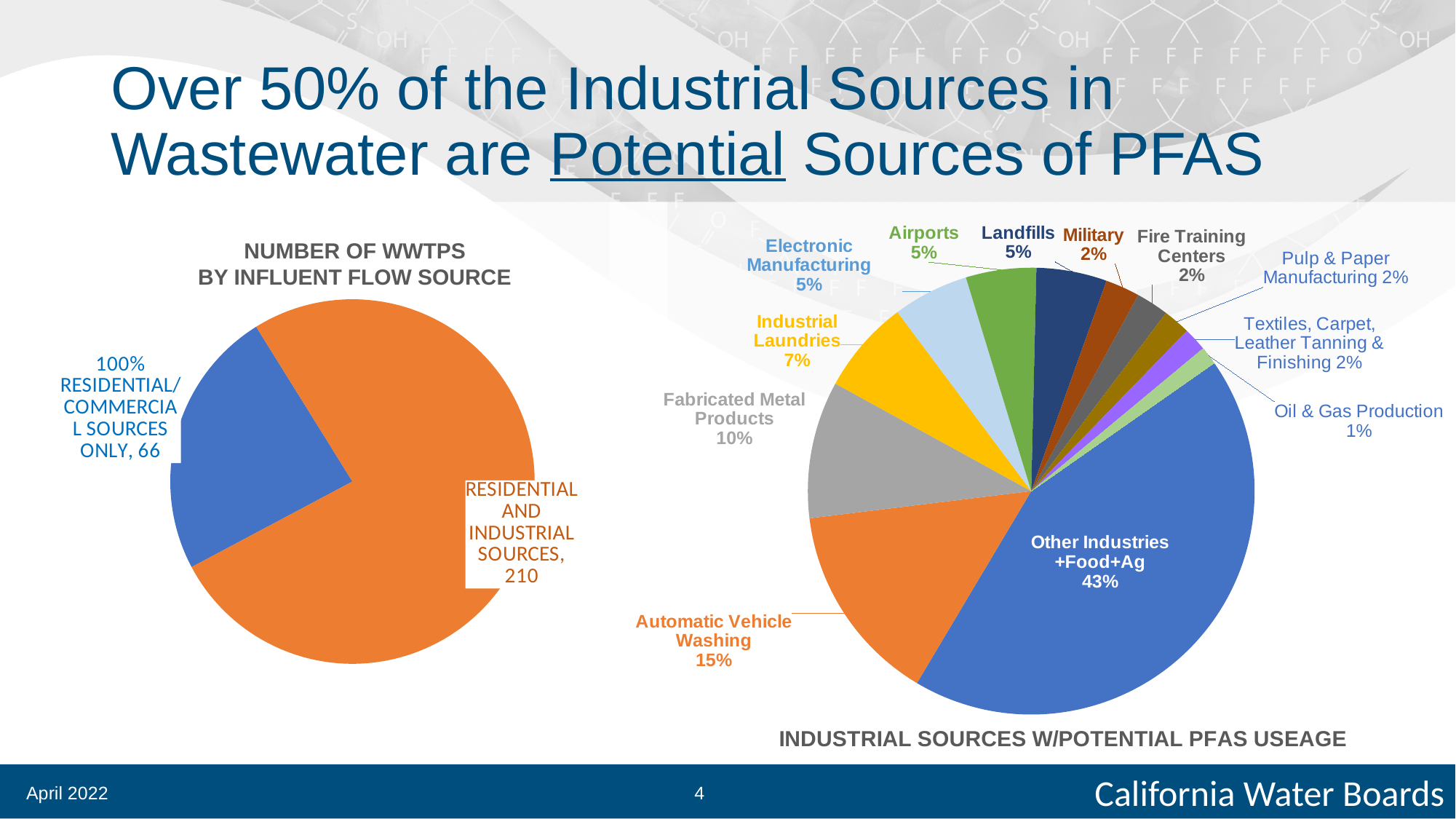
In the chart titled 'NUMBER OF WWTPS BY INFLUENT FLOW SOURCE', what is the total number of WWTPs across both slices? 276 In the chart titled 'NUMBER OF WWTPS BY INFLUENT FLOW SOURCE', what is the value for Residential and Industrial Sources? 210 In the chart titled 'INDUSTRIAL SOURCES W/POTENTIAL PFAS USEAGE', what share does Automatic Vehicle Washing have? 15% In the chart titled 'INDUSTRIAL SOURCES W/POTENTIAL PFAS USEAGE', how many categories are shown? 12 In the chart titled 'NUMBER OF WWTPS BY INFLUENT FLOW SOURCE', what is the value for 100% Residential/Commercial Sources Only? 66 In the chart titled 'INDUSTRIAL SOURCES W/POTENTIAL PFAS USEAGE', what is the difference between the Other Industries+Food+Ag share and the Automatic Vehicle Washing share? 28% In the chart titled 'NUMBER OF WWTPS BY INFLUENT FLOW SOURCE', what is the difference between the Residential and Industrial Sources value and the 100% Residential/Commercial Sources Only value? 144 In the chart titled 'INDUSTRIAL SOURCES W/POTENTIAL PFAS USEAGE', which category has the largest share? Other Industries+Food+Ag What kind of chart is the one titled 'NUMBER OF WWTPS BY INFLUENT FLOW SOURCE'? Pie chart In the chart titled 'INDUSTRIAL SOURCES W/POTENTIAL PFAS USEAGE', what share does Fabricated Metal Products have? 10% In the chart titled 'INDUSTRIAL SOURCES W/POTENTIAL PFAS USEAGE', which category has the smallest share? Oil & Gas Production In the chart titled 'INDUSTRIAL SOURCES W/POTENTIAL PFAS USEAGE', which is larger: Industrial Laundries or Airports? Industrial Laundries